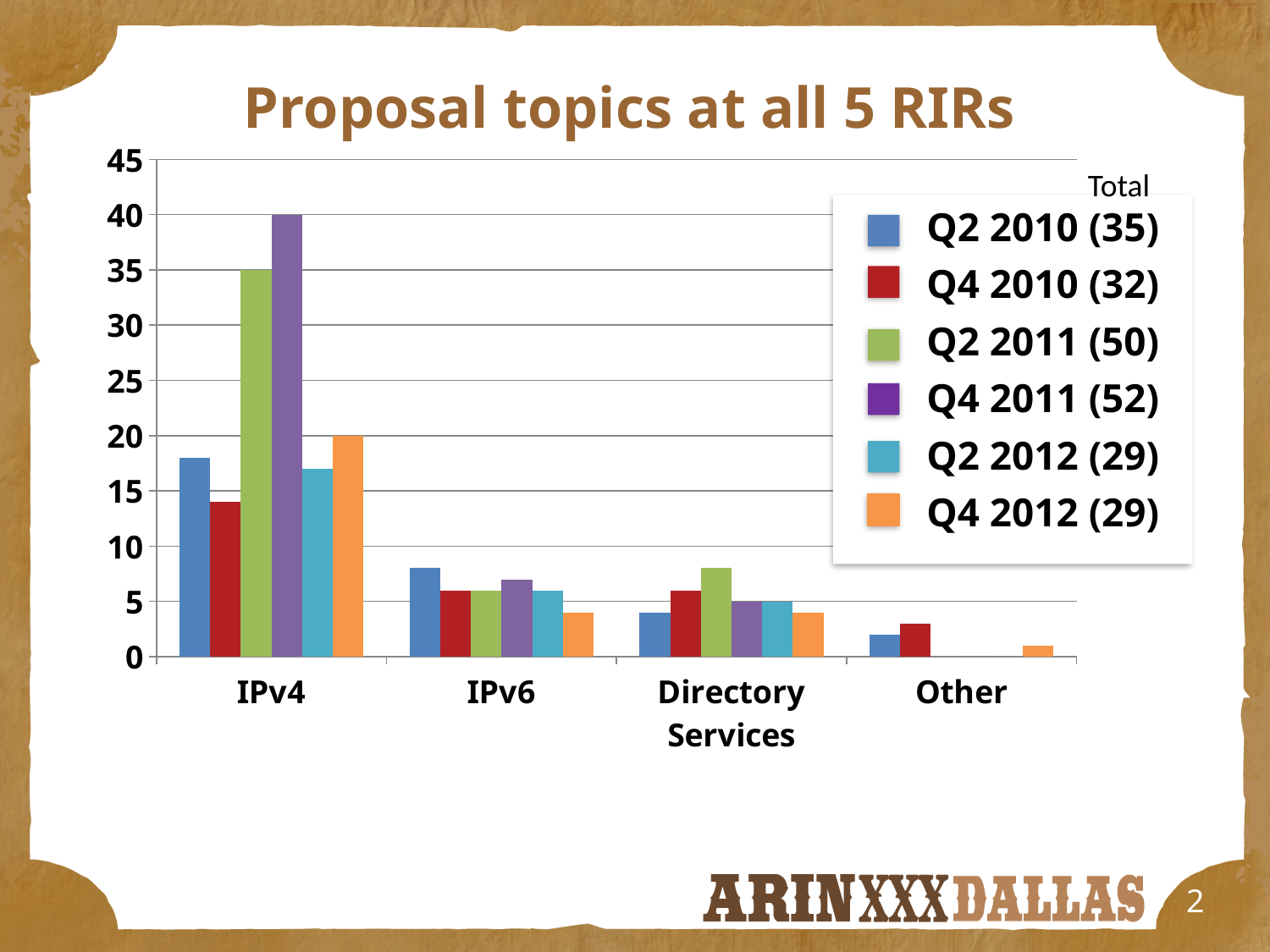
According to the legend, which series has the largest total? Q4 2011 (52) What is the value for Q4 2012 in the IPv4 category? 20 What is the difference between the Q4 2011 and Q2 2011 values in the IPv4 category? 5 How many series does the legend list? 6 Is the value for Q2 2011 in the Directory Services category greater or less than 5? greater Which series has the highest value in the IPv4 category? Q4 2011 (52) Which series has the lowest value in the IPv4 category? Q4 2010 (32) What is the value for Q4 2011 in the IPv4 category? 40 What is the value for Q2 2011 in the IPv4 category? 35 How many categories are shown on the x axis? 4 Is the value for Q2 2010 in the IPv4 category greater or less than 15? greater What kind of chart is shown on the slide? bar chart